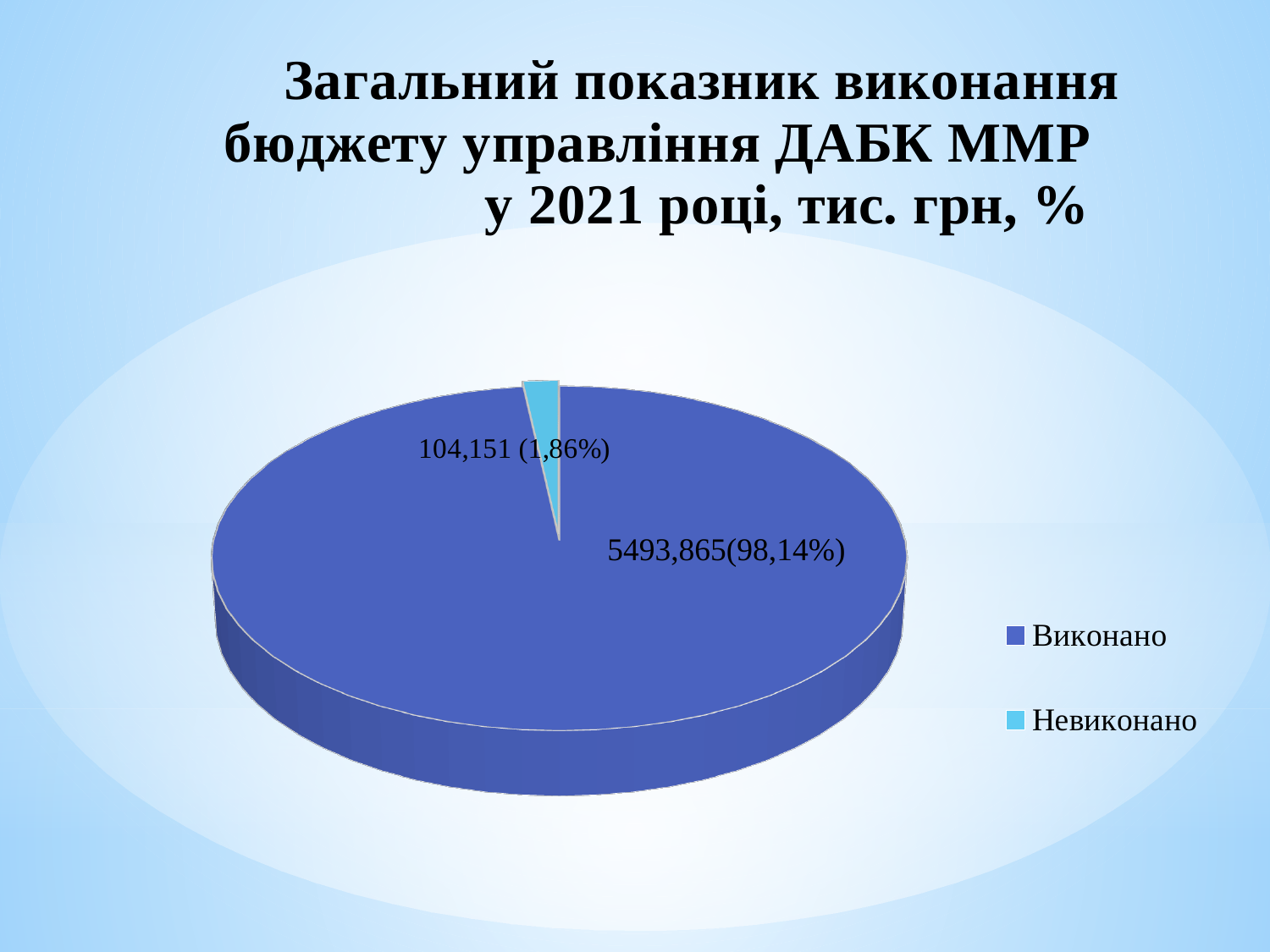
What is the difference between the values for Виконано and Невиконано? 5389,714 What colour is the Невиконано slice in the pie chart? Light blue Which category has the largest slice of the pie? Виконано How many entries does the legend list? 2 What is the value shown for Невиконано? 104,151 Which category has the smallest slice of the pie? Невиконано What share of the pie does Невиконано represent? 1,86% Which is larger, the value for Виконано or the value for Невиконано? Виконано What share of the pie does Виконано represent? 98,14% What kind of chart is shown on the slide? Pie chart What is the value shown for Виконано? 5493,865 How many categories does the pie chart have? 2